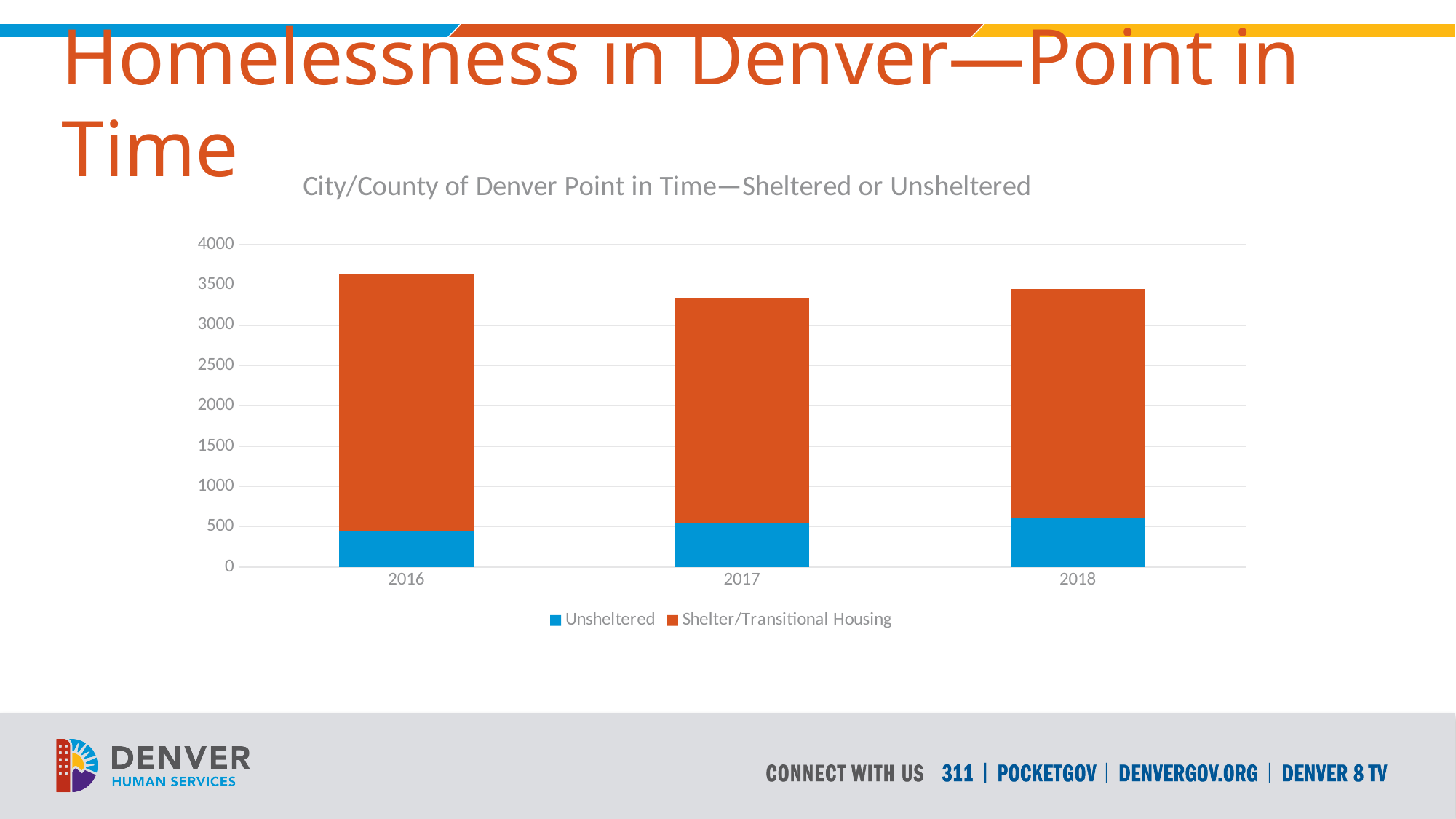
Does the Unsheltered value rise or fall from 2016 to 2018? rise How many years are shown on the x axis of the chart? 3 Which series is shown in blue in the chart? Unsheltered Which year has the highest Unsheltered value? 2018 What kind of chart is shown on the slide? Stacked bar chart What is the title of the chart? City/County of Denver Point in Time—Sheltered or Unsheltered Is the total bar for 2017 greater or less than 3500? less Which year has the highest total bar in the chart? 2016 Which year has the lowest Unsheltered value? 2016 How many series does the chart's legend list? 2 Is the Unsheltered value for 2016 greater or less than 500? less Is the total bar for 2016 greater or less than 3500? greater